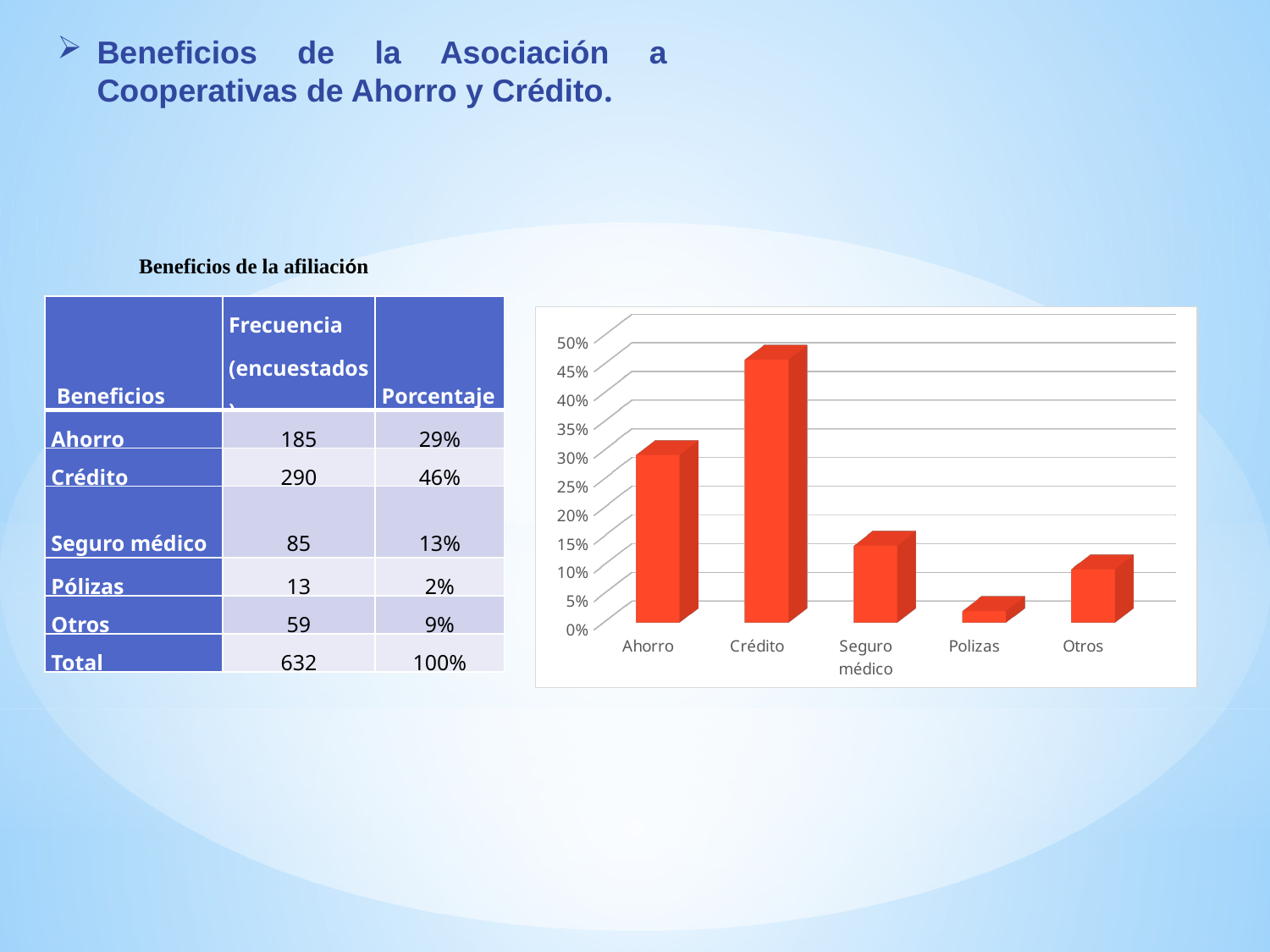
What kind of chart is shown on the slide? bar chart What is the highest tick value shown on the chart's vertical axis? 50% Is the value for Ahorro in the chart greater or less than 25%? greater Is the value for Otros in the chart greater or less than 15%? less According to the slide, what percentage corresponds to Crédito? 46% Which category has the lowest bar in the chart? Polizas Which bar is taller in the chart, Otros or Polizas? Otros How many categories are plotted on the x axis of the chart? 5 Which category has the highest bar in the chart? Crédito Which bar is taller in the chart, Ahorro or Seguro médico? Ahorro Is the value for Seguro médico in the chart greater or less than 10%? greater According to the slide, what percentage corresponds to Ahorro? 29%